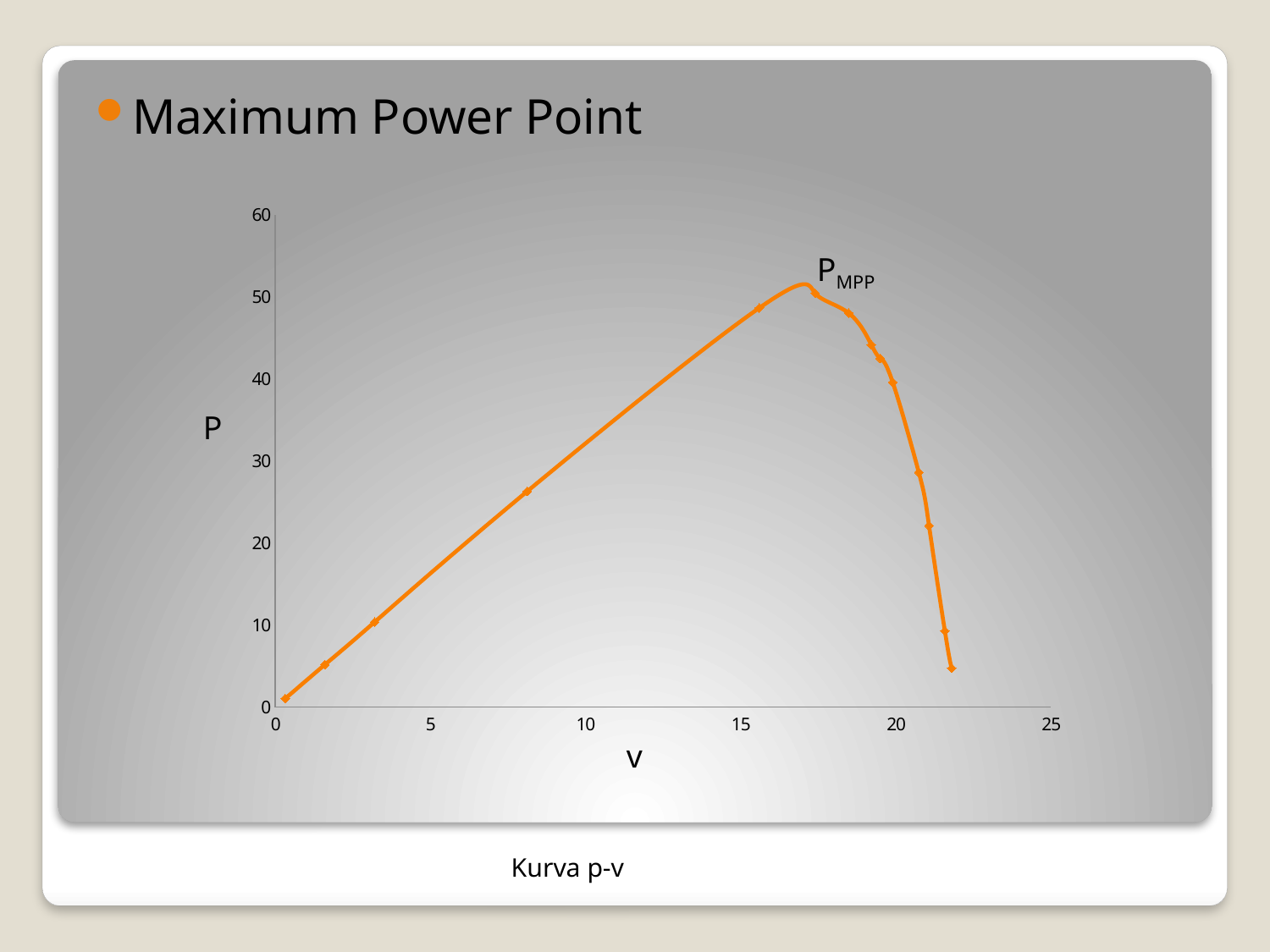
Is the value of P at the data point near v = 20 greater or less than 30? greater Is the peak value of P on the curve greater or less than 60? less Does the value of P rise or fall as v increases from 20 to 22? fall What is the label on the vertical axis of the chart? P Is the peak value of P on the curve greater or less than 40? greater What is the label on the horizontal axis of the chart? v What kind of chart is shown on the slide? line chart Does the value of P rise or fall as v increases from 0 to 15? rise